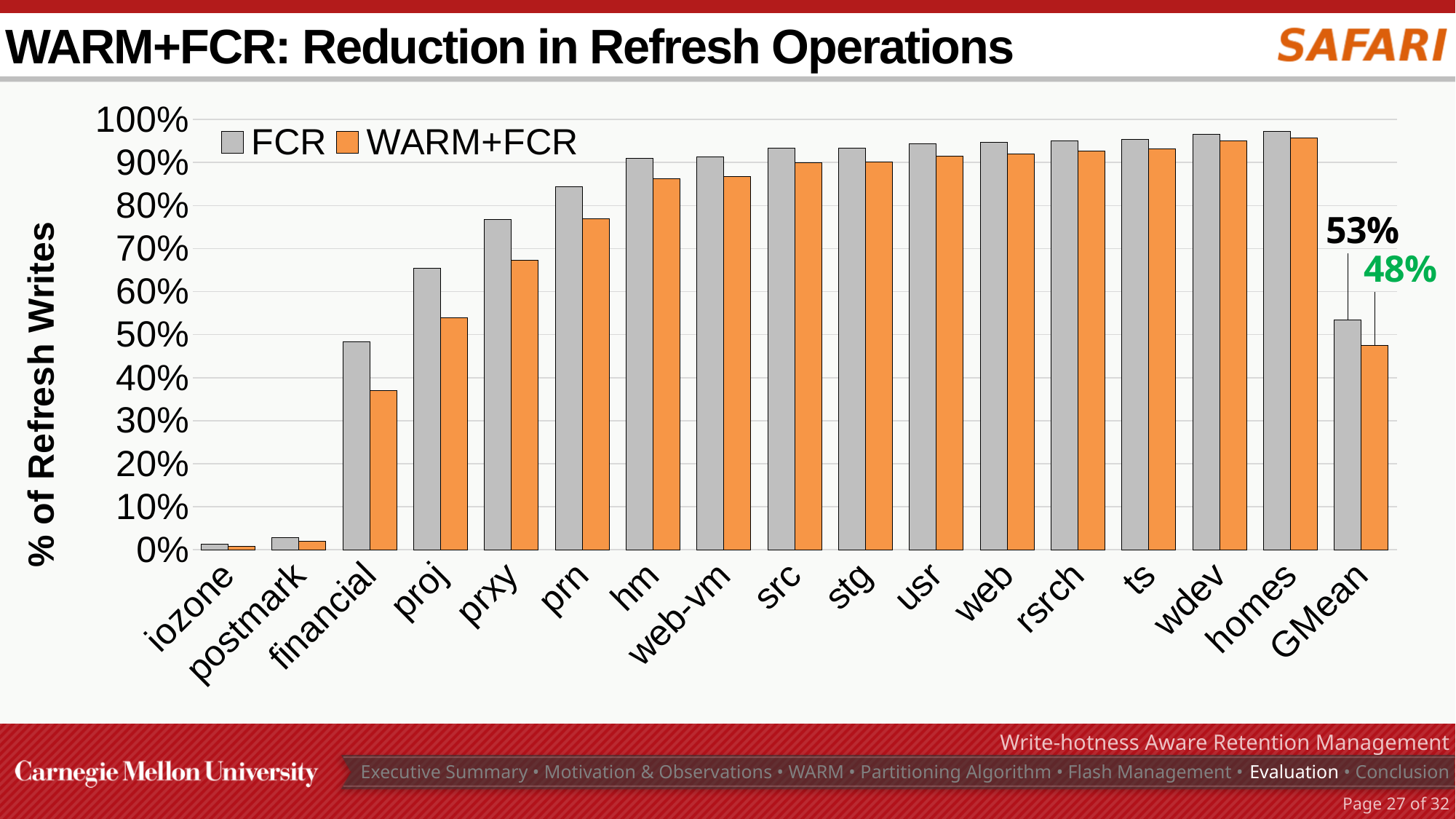
Is the WARM+FCR value for financial greater or less than 50%? less Is the FCR value for proj greater or less than 60%? greater How many categories are shown on the x axis? 17 What is the difference between the FCR and WARM+FCR values for GMean? 5 percentage points What kind of chart is shown on the slide? Bar chart What is the label on the y axis? % of Refresh Writes What is the WARM+FCR value for GMean? 48% Do the values generally rise or fall from iozone to homes along the x axis? Rise Which category has the lowest FCR value? iozone How many series does the legend list? 2 What is the FCR value for GMean? 53% For financial, which is larger: the FCR value or the WARM+FCR value? FCR